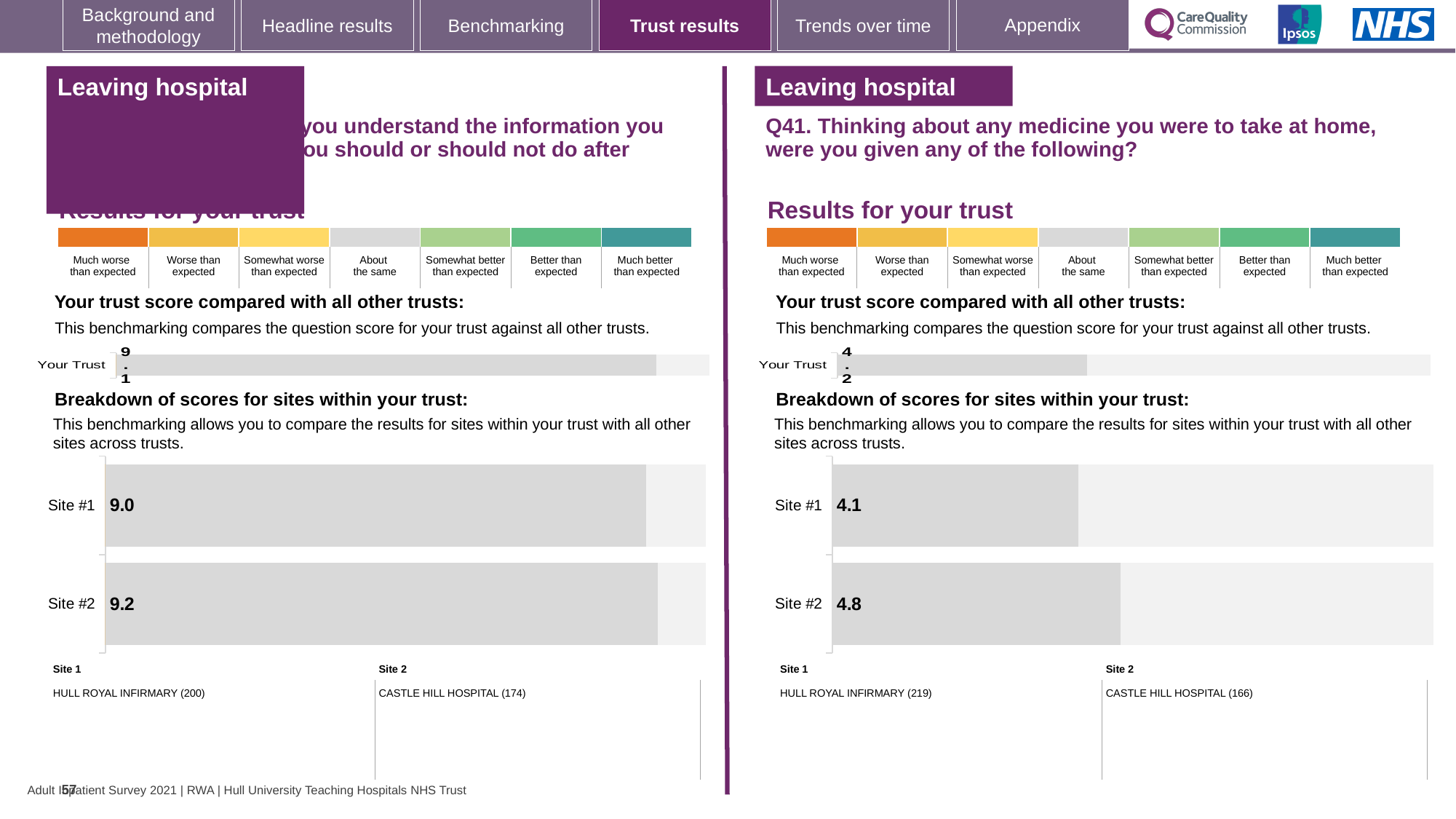
On the left-hand site breakdown chart, what is the difference between the Site #2 and Site #1 scores? 0.2 On the right-hand (Q41) site breakdown chart, which hospital is listed as Site 2? CASTLE HILL HOSPITAL (166) How many sites are shown on the right-hand (Q41) site breakdown chart? 2 On the right-hand (Q41) site breakdown chart, which site has the higher score? Site #2 On the right-hand (Q41) site breakdown chart, what is the difference between the Site #2 and Site #1 scores? 0.7 What type of chart is used for the site breakdown on the left-hand side of the slide? Bar chart On the right-hand (Q41) site breakdown chart, what is the score for Site #2? 4.8 On the left-hand 'Your trust score compared with all other trusts' chart, what is the score shown for Your Trust? 9.1 On the right-hand (Q41) site breakdown chart, what is the score for Site #1? 4.1 On the left-hand site breakdown chart, what is the score for Site #2? 9.2 On the right-hand (Q41) 'Your trust score compared with all other trusts' chart, what is the score shown for Your Trust? 4.2 On the left-hand site breakdown chart, what is the score for Site #1? 9.0